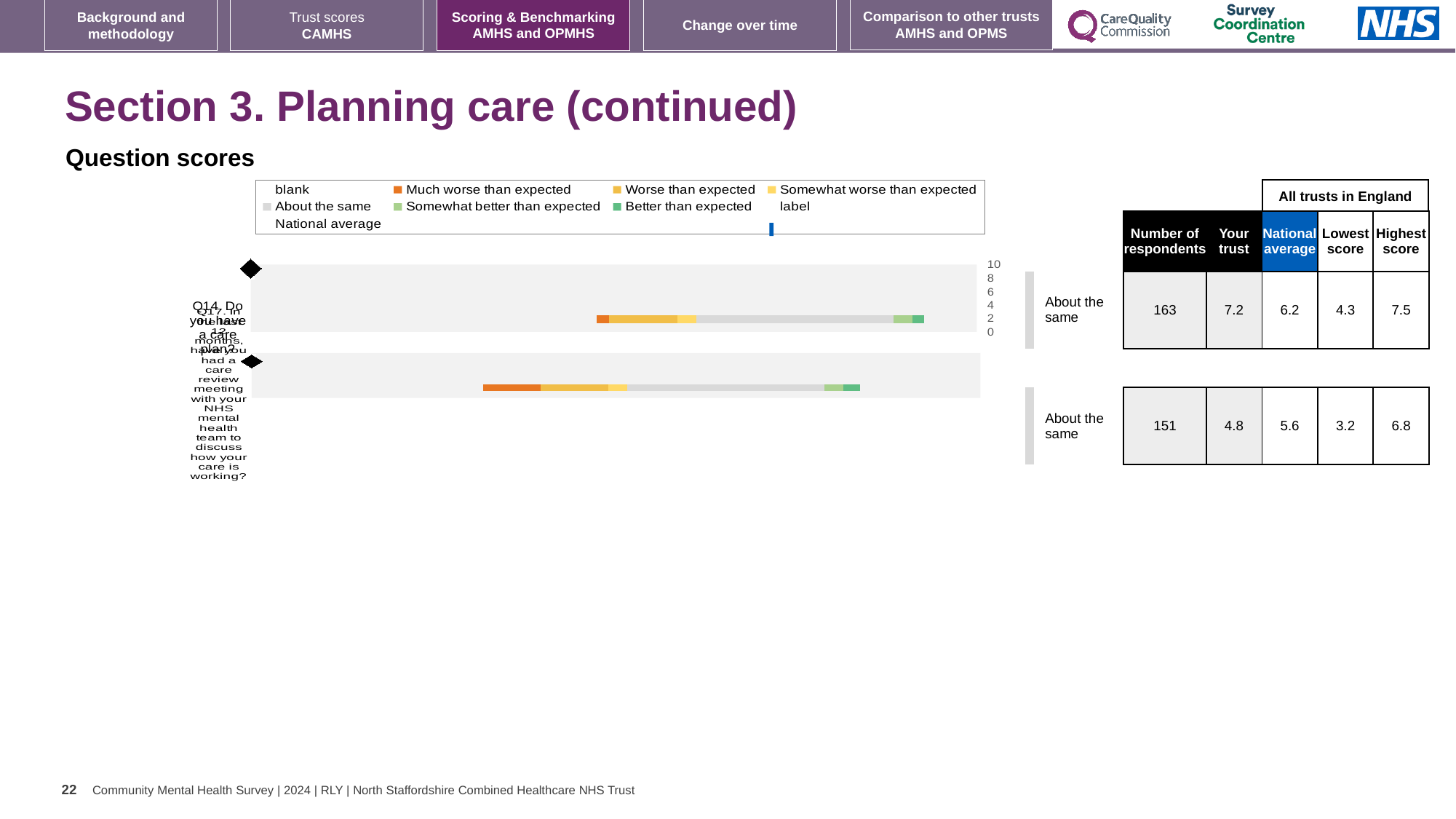
What benchmark category is shown for both Q14 and Q17? About the same What kind of chart is shown under 'Question scores'? bar chart Which two questions are plotted in the chart? Q14 and Q17 In the table beside the chart, what is the lowest score for Q14? 4.3 What is the difference in number of respondents between Q14 and Q17? 12 In the table beside the chart, what is the national average for Q14? 6.2 How many question bars are plotted in the chart? 2 Which question has more respondents, Q14 or Q17? Q14 In the table beside the chart, what is the number of respondents for Q14? 163 In the table beside the chart, what is the 'Your trust' score for Q17? 4.8 In the table beside the chart, what is the highest score for Q17? 6.8 What colour does the legend use for 'Much worse than expected'? orange